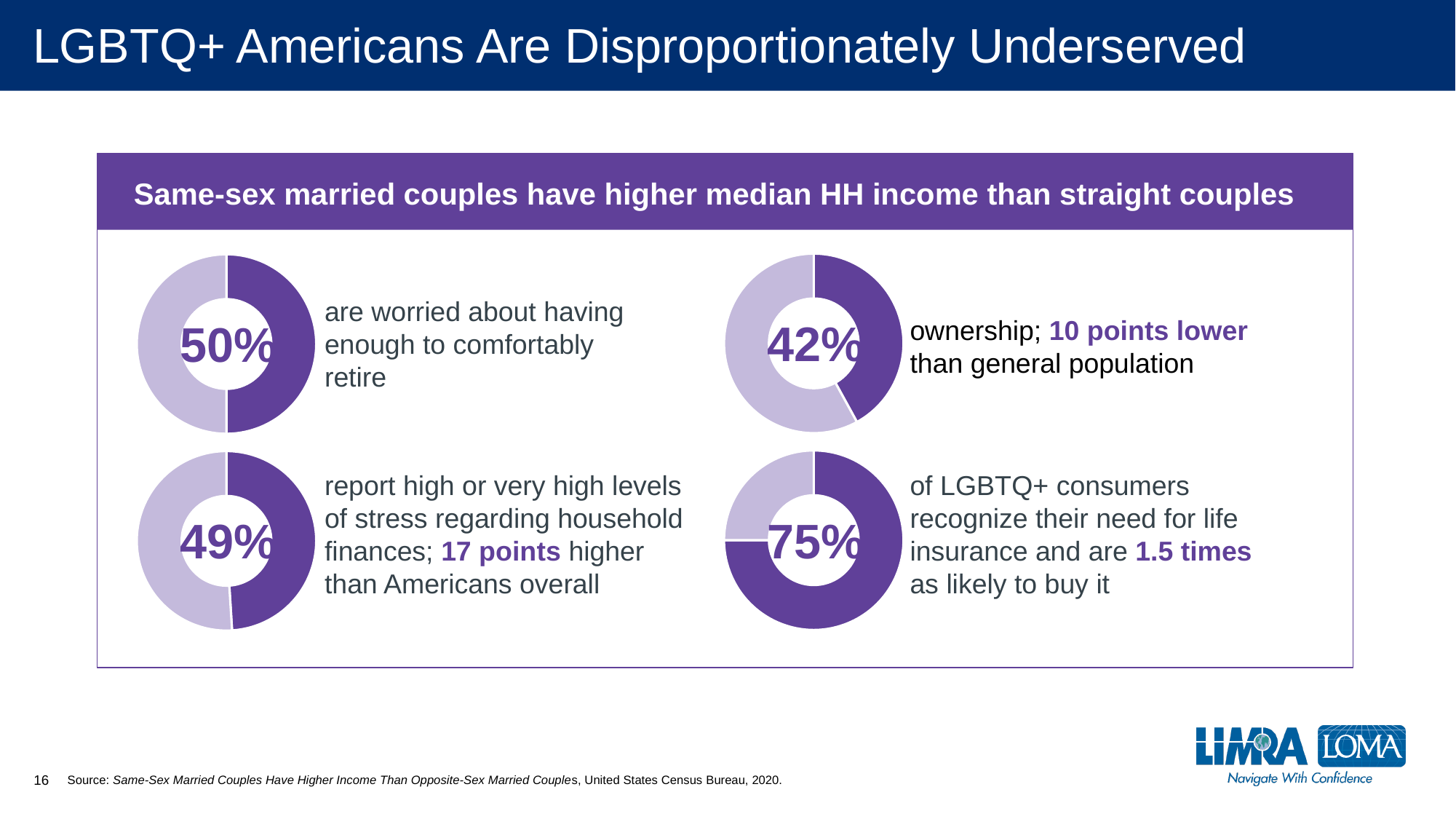
Which of the four donut charts shows the highest percentage? The bottom-right chart (75%) What colour is the filled (highlighted) portion of each donut chart? Dark purple What value is shown in the top-left donut chart about being worried about having enough to comfortably retire? 50% Which of the four donut charts shows the lowest percentage? The top-right chart (42%) Is the percentage in the bottom-right donut chart (recognize need for life insurance) larger or smaller than the percentage in the top-right donut chart (ownership)? Larger What value is shown in the bottom-left donut chart about high or very high levels of stress regarding household finances? 49% What value is shown in the top-right donut chart about ownership? 42% What is the difference between the value in the bottom-right donut chart (75%) and the value in the top-right donut chart (42%)? 33 percentage points What value is shown in the bottom-right donut chart about LGBTQ+ consumers recognizing their need for life insurance? 75% What kind of chart is used for each of the four statistics on the slide? Donut chart How many donut charts are shown on the slide? 4 What is the difference between the value in the top-left donut chart (50%) and the value in the bottom-left donut chart (49%)? 1 percentage point